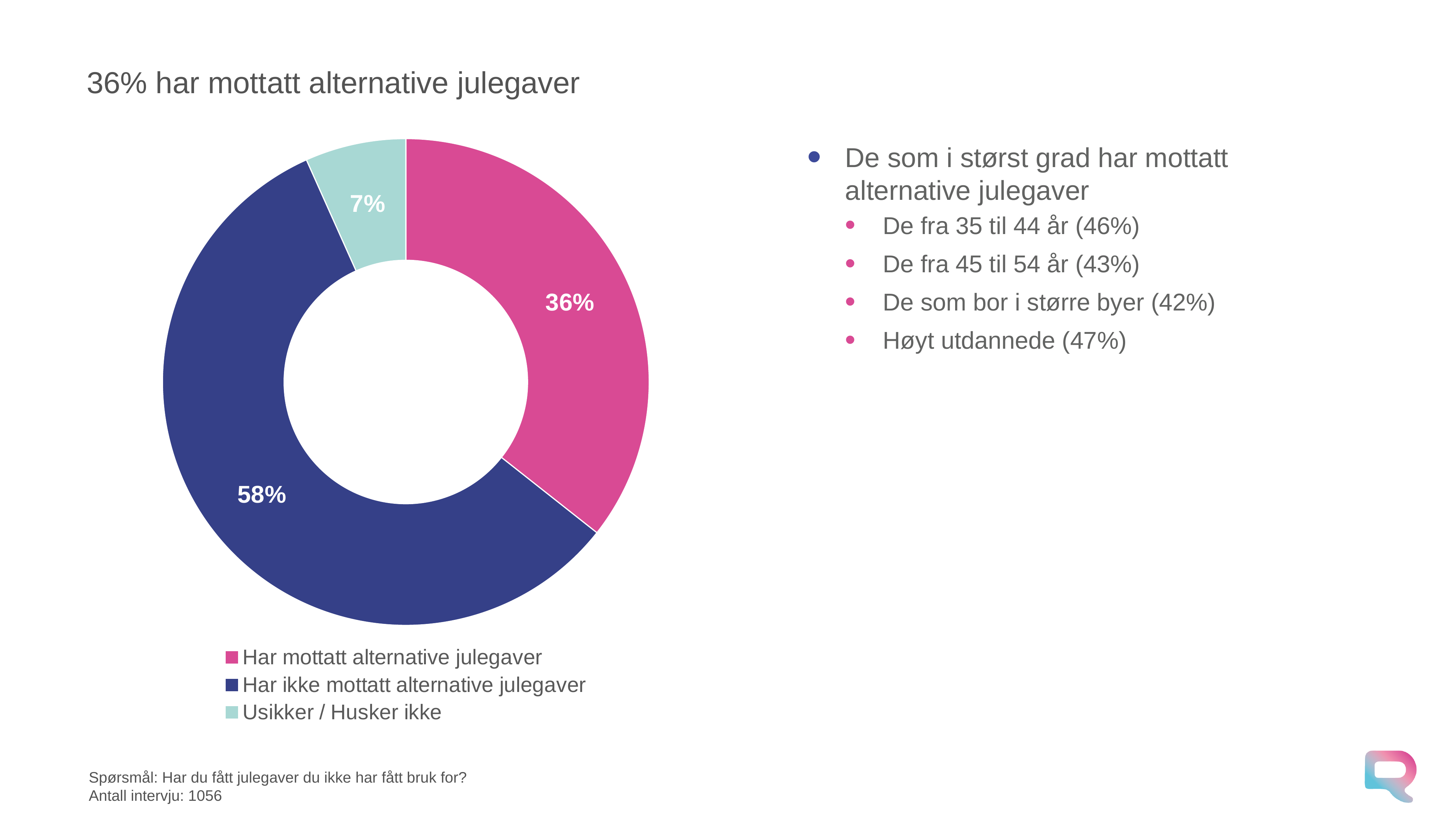
What is the difference in percentage points between Har ikke mottatt alternative julegaver and Har mottatt alternative julegaver? 22 Which category has the smallest share of the chart? Usikker / Husker ikke What percentage of respondents have received alternative Christmas gifts (Har mottatt alternative julegaver)? 36% How many categories does the chart show? 3 What percentage of respondents have not received alternative Christmas gifts (Har ikke mottatt alternative julegaver)? 58% What is the title of the slide above the chart? 36% har mottatt alternative julegaver What colour is the slice for Har ikke mottatt alternative julegaver? Dark blue What kind of chart is shown on the slide? Pie chart (doughnut) What percentage of respondents answered Usikker / Husker ikke? 7% What is the combined share of Har mottatt alternative julegaver and Usikker / Husker ikke? 43% Which category has the largest share of the chart? Har ikke mottatt alternative julegaver Which is larger: the share for Har mottatt alternative julegaver or the share for Usikker / Husker ikke? Har mottatt alternative julegaver